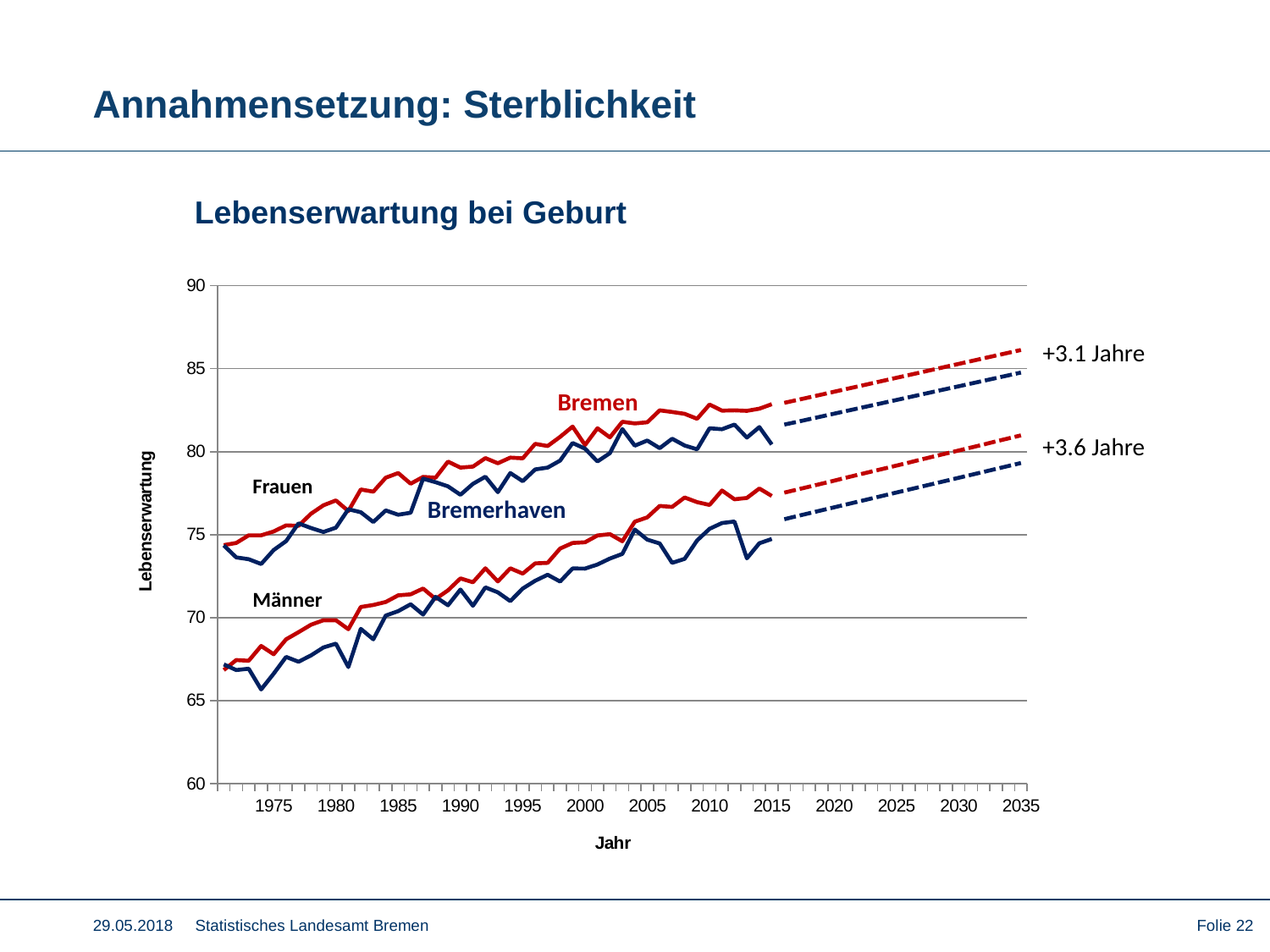
Which colour is used for the Bremen lines? red Do the life expectancy lines generally rise or fall from 1975 to 2015? rise What is the label of the vertical axis? Lebenserwartung What is the title of the chart? Lebenserwartung bei Geburt Which group has the higher life expectancy throughout the chart: Frauen or Männer? Frauen How many years of additional life expectancy does the annotation next to the Männer projection show? +3.6 Jahre In 2015, which has the higher life expectancy for Männer: Bremen or Bremerhaven? Bremen How many years of additional life expectancy does the annotation next to the Frauen projection show? +3.1 Jahre Is the life expectancy of Männer in Bremen in 2015 greater or less than 75? greater Is the life expectancy of Frauen in Bremen in 2015 greater or less than 80? greater What kind of chart is shown on the slide? line chart Is the life expectancy of Männer in Bremerhaven in 1975 greater or less than 70? less